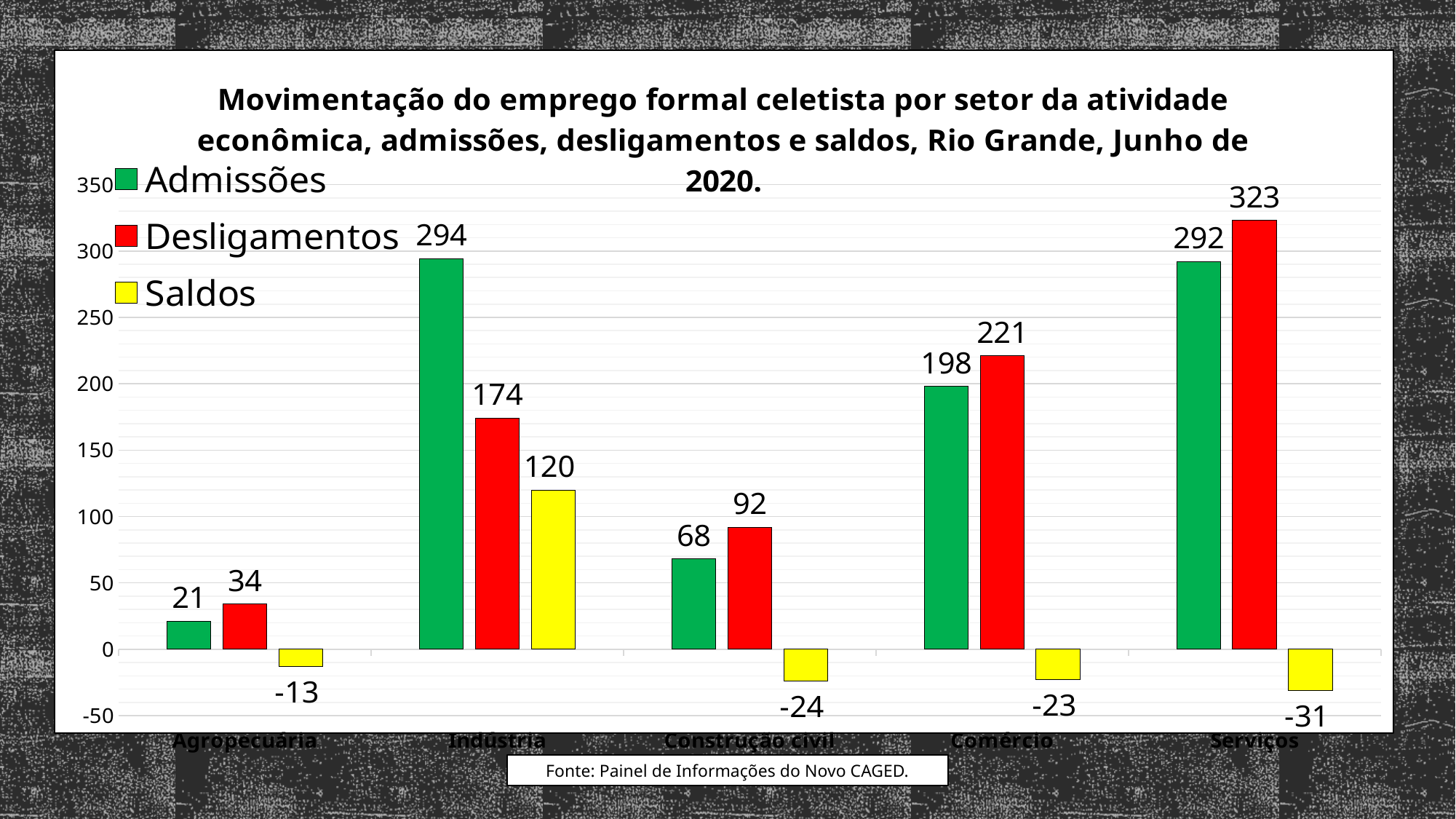
What is the difference between Desligamentos and Admissões for Comércio? 23 Is the Admissões value for Comércio greater or less than 150? greater How many sectors are shown on the x axis? 5 What is the Desligamentos value for Serviços? 323 What is the Saldos value for Construção civil? -24 Which colour represents the Saldos series? Yellow Which sector has the highest Admissões value? Indústria What is the Admissões value for Indústria? 294 How many series does the legend list? 3 What kind of chart is shown on the slide? Bar chart Which is larger for Serviços, Admissões or Desligamentos? Desligamentos Which sector has the lowest Desligamentos value? Agropecuária